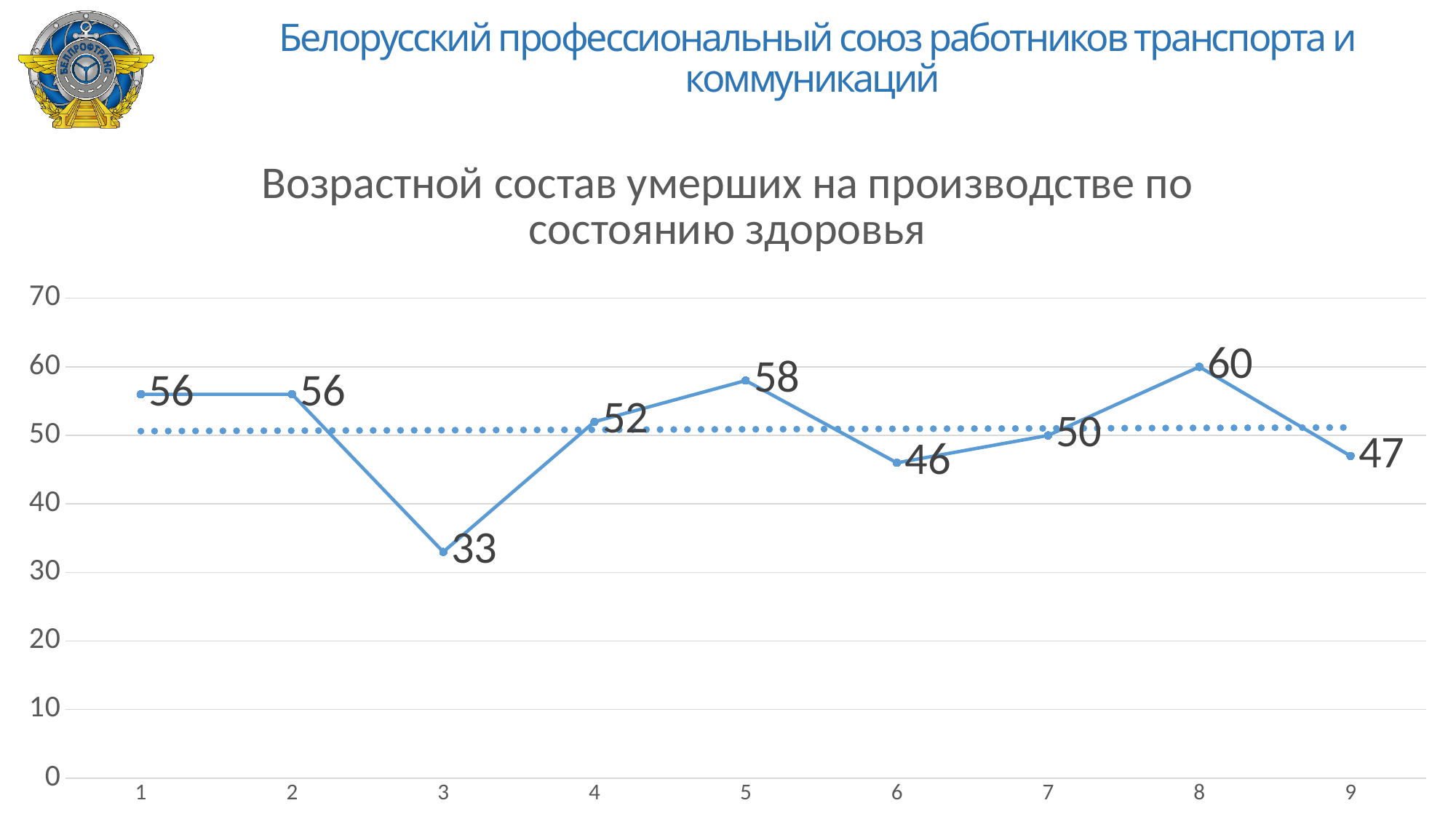
Which is larger, the value at point 5 or the value at point 6? point 5 Does the value rise or fall from point 8 to point 9? fall Which point has the lowest value? 3 What is the value at point 5? 58 How many data points are plotted on the line? 9 What is the title of the chart? Возрастной состав умерших на производстве по состоянию здоровья What is the difference between the values at point 8 and point 3? 27 What kind of chart is shown on the slide? line chart What is the value at point 3? 33 Is the value at point 9 greater or less than 50? less What is the value at point 8? 60 Which point has the highest value? 8